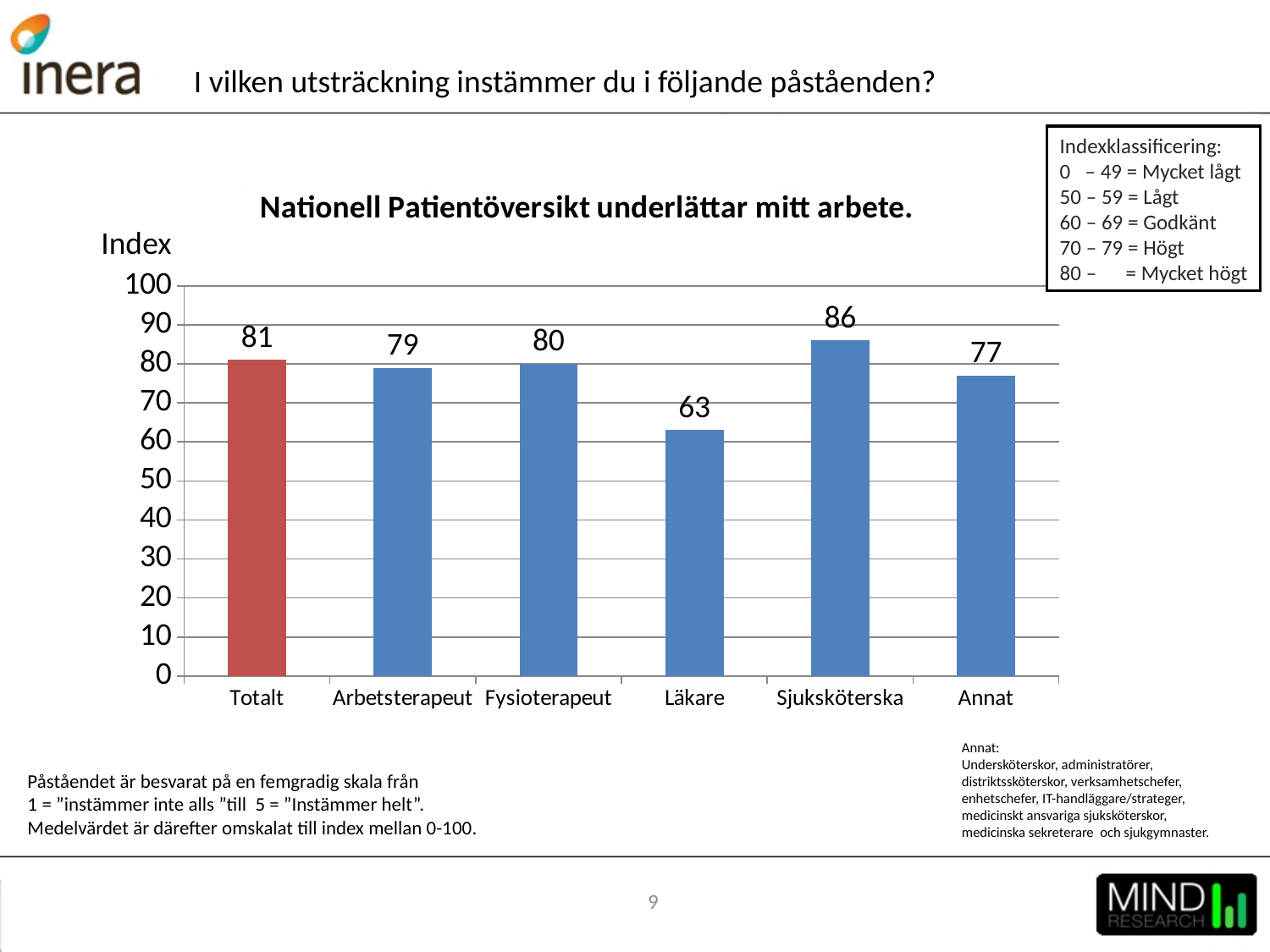
Which category has the highest index value? Sjuksköterska How many categories are shown on the x axis? 6 Which category has the lowest index value? Läkare What is the index value for Sjuksköterska? 86 Is the value for Annat greater or less than 80? less What is the index value for Totalt? 81 What is the index value for Läkare? 63 What is the difference between the index values for Sjuksköterska and Läkare? 23 What is the index value for Annat? 77 Which has a higher index value, Arbetsterapeut or Fysioterapeut? Fysioterapeut What kind of chart is shown on the slide? bar chart What is the title of the chart? Nationell Patientöversikt underlättar mitt arbete.